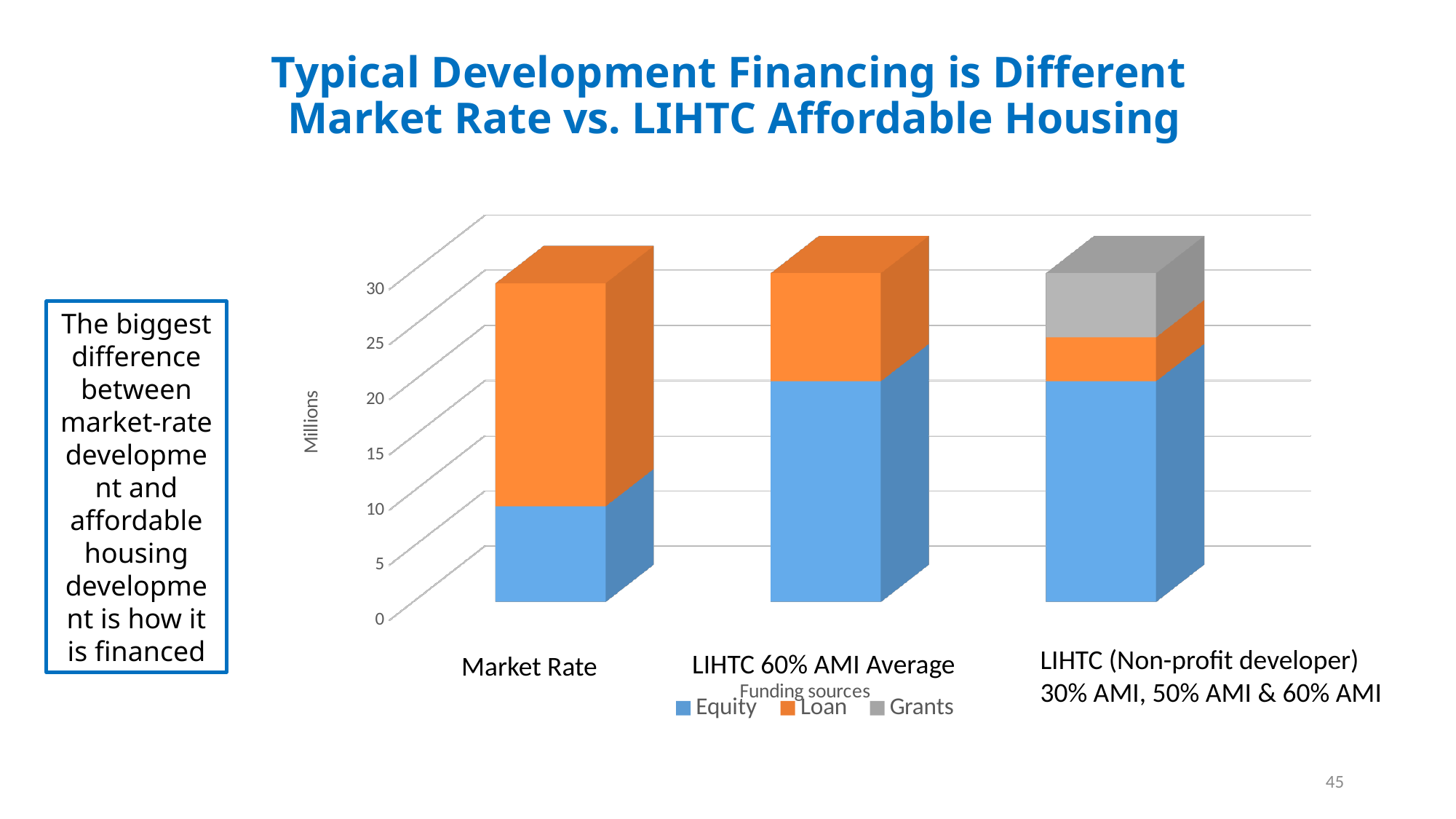
Is the Equity value for Market Rate greater or less than 15? less Which category has the smallest Equity segment? Market Rate Which is larger, the Equity segment for Market Rate or the Equity segment for LIHTC 60% AMI Average? LIHTC 60% AMI Average How many categories are shown on the x axis of the chart? 3 Which series are listed in the chart legend? Equity, Loan, Grants What kind of chart is shown on the slide? Stacked bar chart What unit is shown on the vertical axis of the chart? Millions Which category is the only one with a Grants segment? LIHTC (Non-profit developer) 30% AMI, 50% AMI & 60% AMI Which category has the smallest Loan segment? LIHTC (Non-profit developer) 30% AMI, 50% AMI & 60% AMI How many series does the chart legend list? 3 Which category has the largest Loan segment? Market Rate Is the Equity value for LIHTC 60% AMI Average greater or less than 15? greater